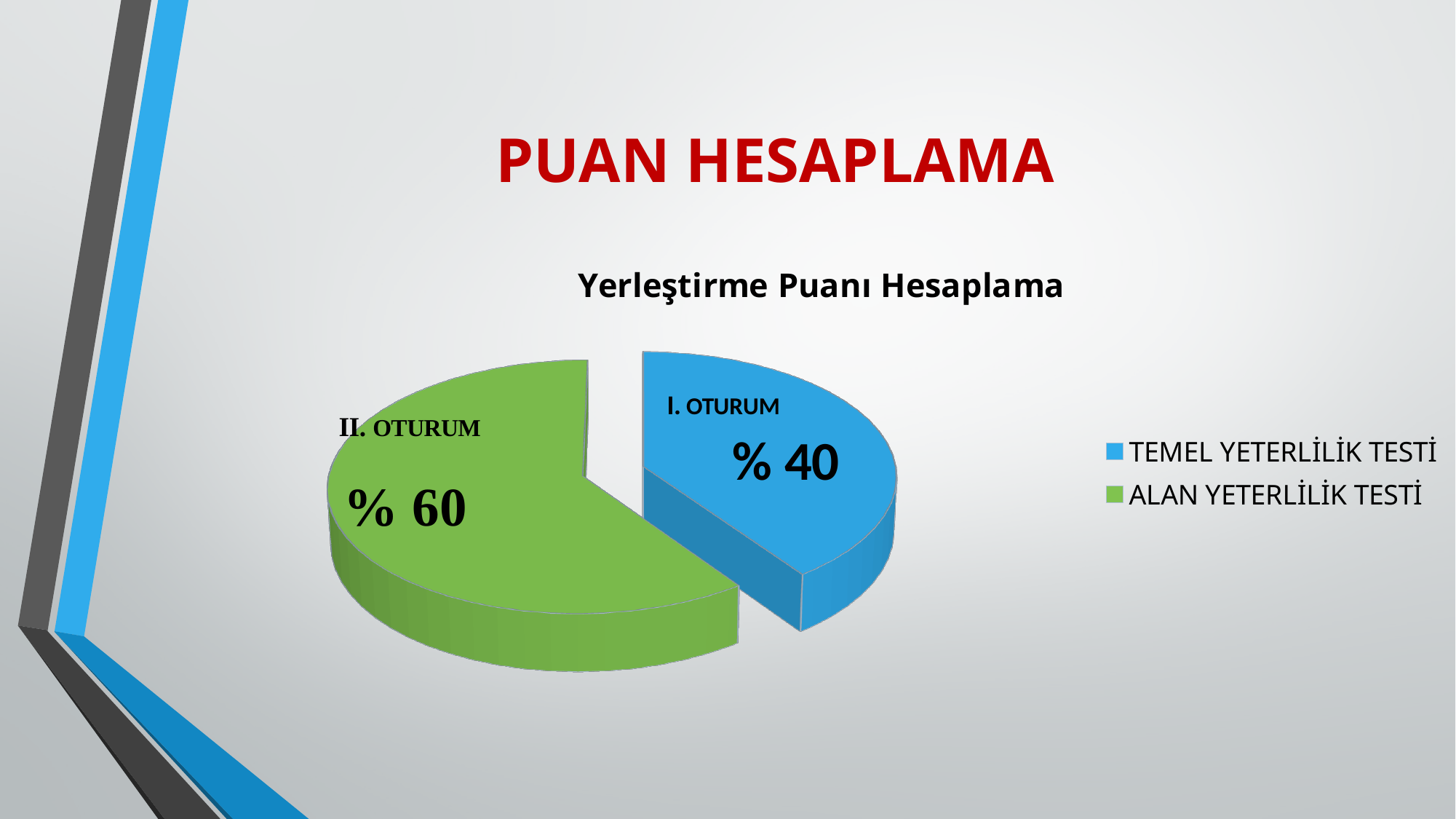
How many entries does the legend list? 2 What colour is the slice for TEMEL YETERLİLİK TESTİ? Blue What value is shown for ALAN YETERLİLİK TESTİ? % 60 What is the difference between the ALAN YETERLİLİK TESTİ and TEMEL YETERLİLİK TESTİ values? % 20 How many slices does the pie chart have? 2 What is the title of the chart? Yerleştirme Puanı Hesaplama What kind of chart is shown on the slide? Pie chart Which session label (OTURUM) is shown on the ALAN YETERLİLİK TESTİ slice? II. OTURUM Which slice is the smallest in the pie chart? TEMEL YETERLİLİK TESTİ Which is larger, TEMEL YETERLİLİK TESTİ or ALAN YETERLİLİK TESTİ? ALAN YETERLİLİK TESTİ Which slice is the largest in the pie chart? ALAN YETERLİLİK TESTİ What value is shown for TEMEL YETERLİLİK TESTİ? % 40